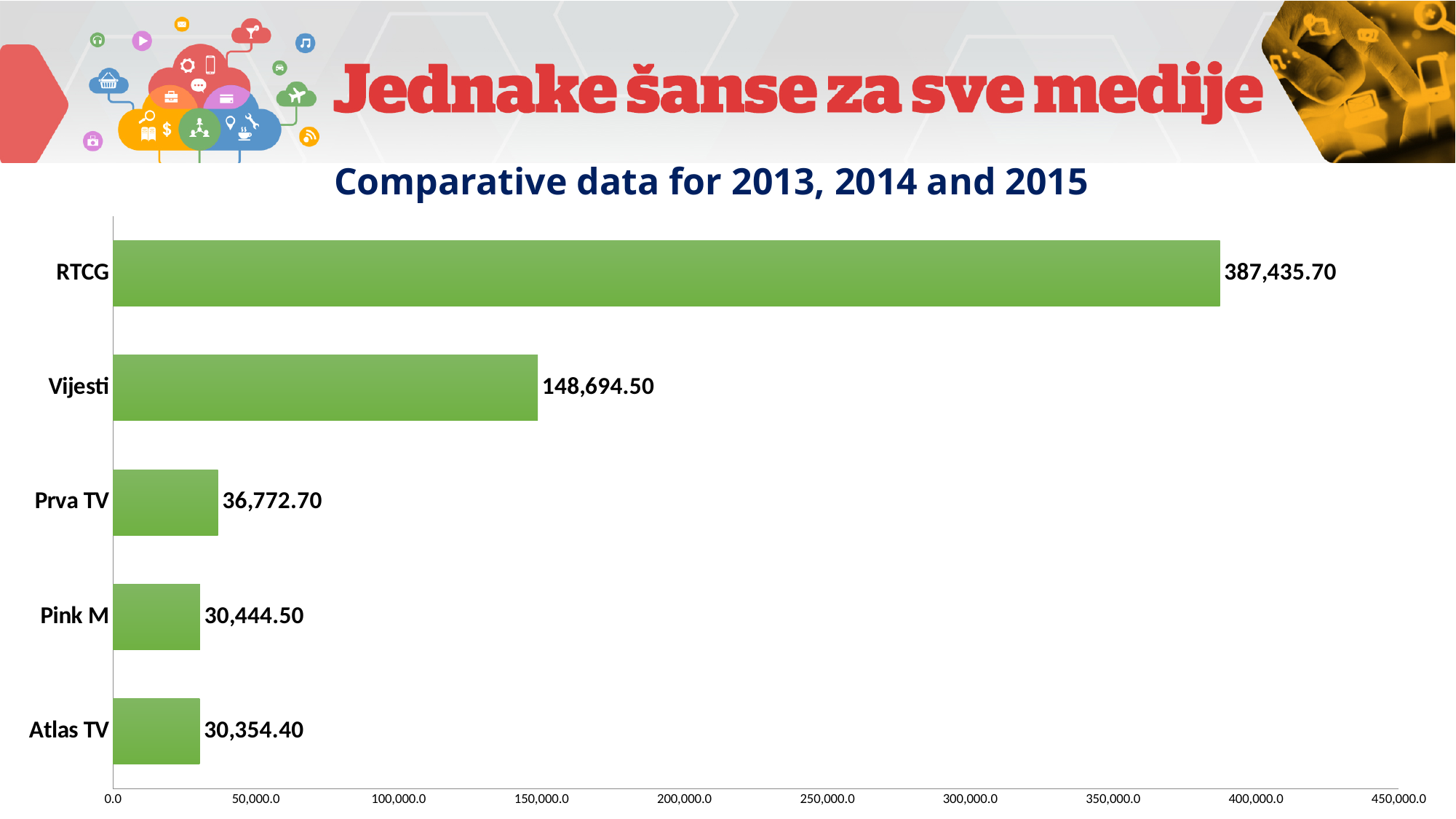
What is the value for Atlas TV? 30,354.40 What is the value for RTCG? 387,435.70 What kind of chart is shown on the slide? bar chart What is the value for Vijesti? 148,694.50 What is the value for Prva TV? 36,772.70 Is the value for RTCG greater or less than 350,000? greater Which has a larger value, Vijesti or Prva TV? Vijesti Which category has the highest value? RTCG What is the difference between the values for Vijesti and Prva TV? 111,921.80 How many categories are shown in the chart? 5 What is the value for Pink M? 30,444.50 What is the difference between the values for RTCG and Vijesti? 238,741.20